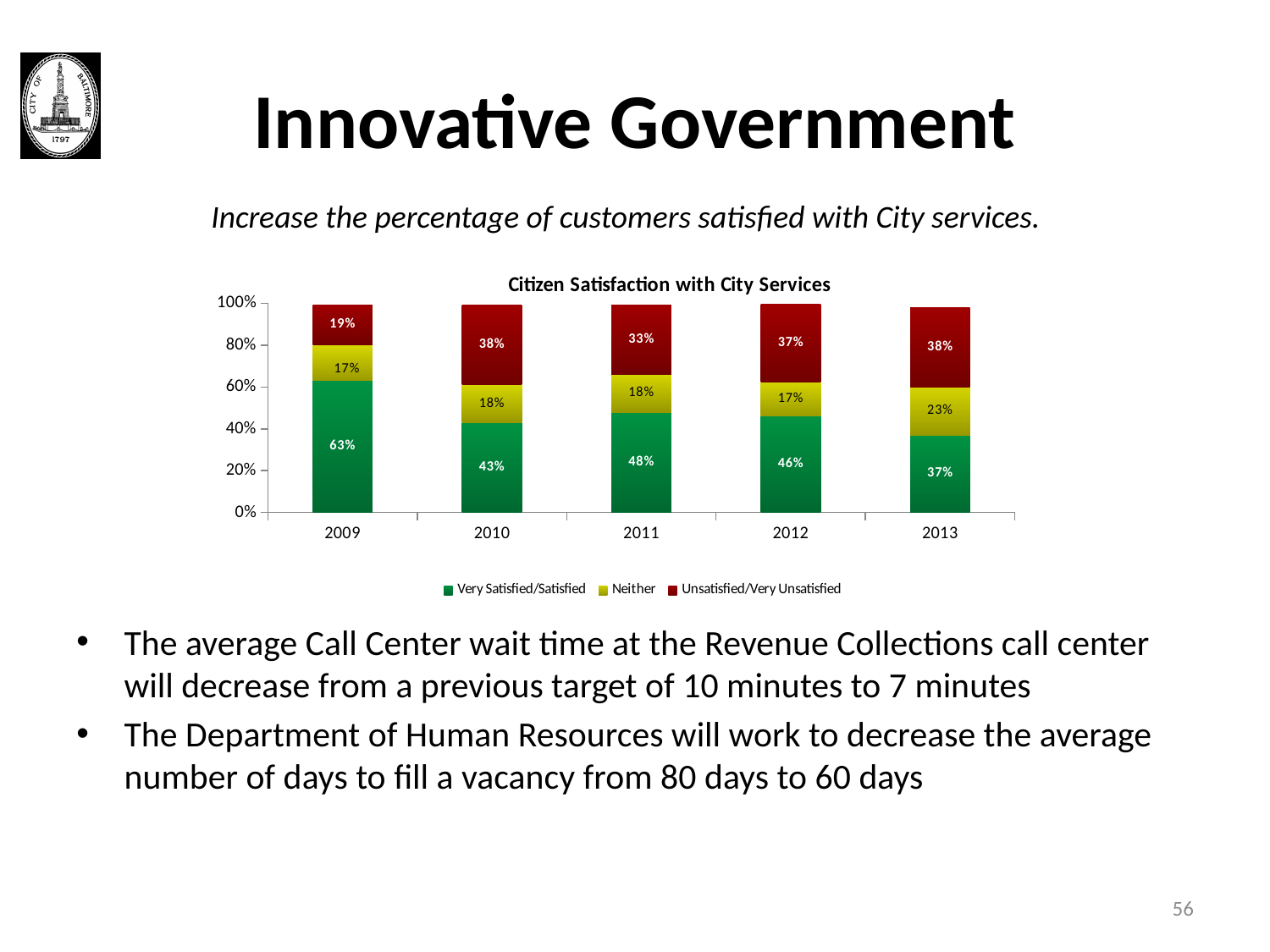
Is the Unsatisfied/Very Unsatisfied value larger in 2010 or in 2011? 2010 What kind of chart is shown? Stacked bar chart Which year has the highest Very Satisfied/Satisfied value? 2009 How many years are shown on the x axis? 5 What is the Unsatisfied/Very Unsatisfied value for 2011? 33% What is the title of the chart? Citizen Satisfaction with City Services What is the Neither value for 2013? 23% How many series does the legend list? 3 What is the Very Satisfied/Satisfied value for 2009? 63% What is the difference between the Very Satisfied/Satisfied values for 2009 and 2013? 26% Which year has the lowest Very Satisfied/Satisfied value? 2013 What is the total of the stacked bar for 2012? 100%